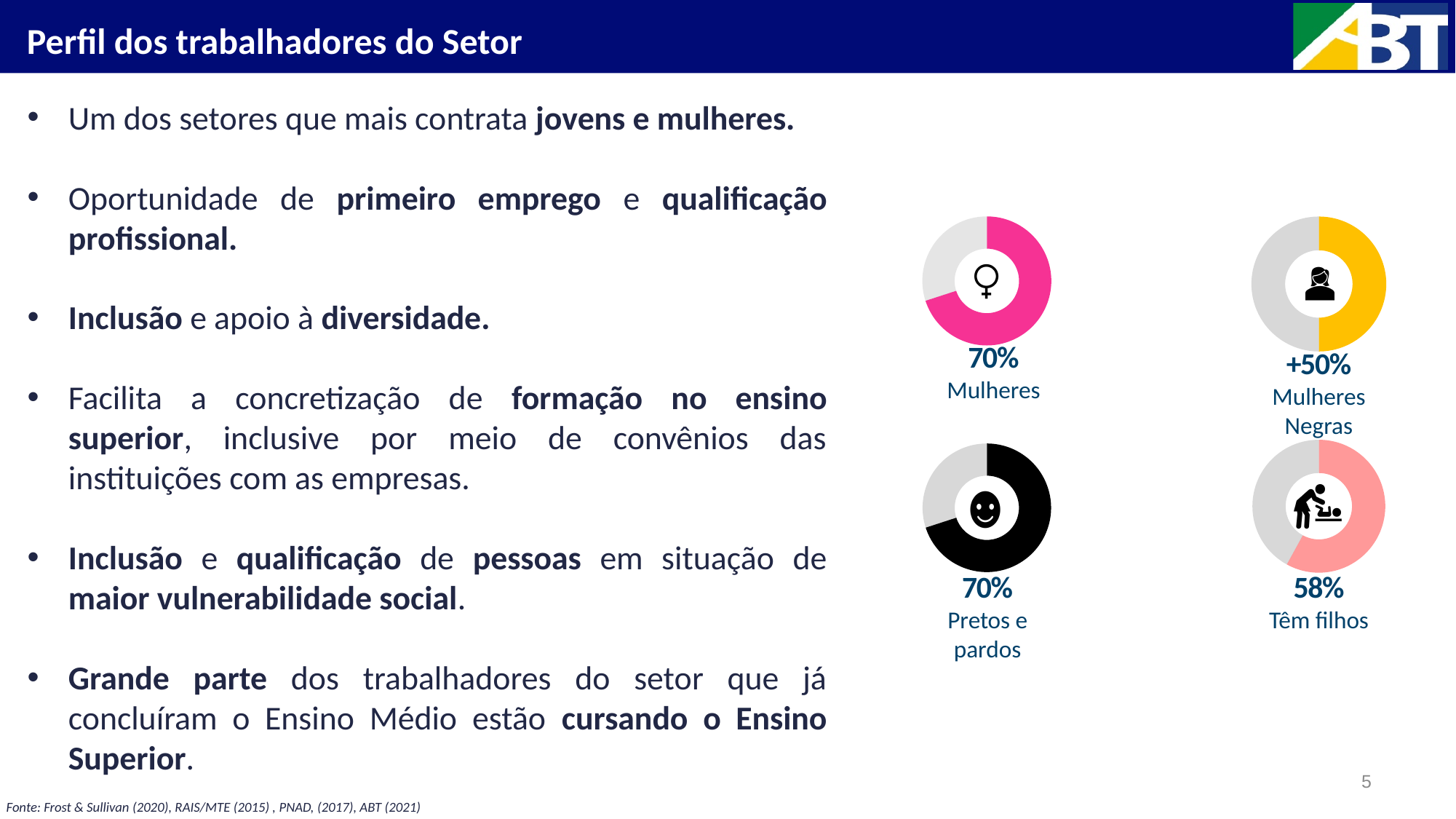
What colour is the filled portion of the 'Mulheres Negras' donut chart? Yellow What percentage is shown for the 'Mulheres' donut chart? 70% What is the difference in percentage points between the 'Pretos e pardos' value and the 'Têm filhos' value? 12 percentage points What value is shown for the 'Mulheres Negras' donut chart? +50% What percentage is shown for the 'Pretos e pardos' donut chart? 70% What percentage is shown for the 'Têm filhos' donut chart? 58% What colour is the filled portion of the 'Pretos e pardos' donut chart? Black What kind of charts are used on the right side of the slide? Donut (pie) charts Which is larger, the value for 'Mulheres' or the value for 'Têm filhos'? Mulheres Is the value for 'Têm filhos' greater or less than 50%? greater How many donut charts are shown on the slide? 4